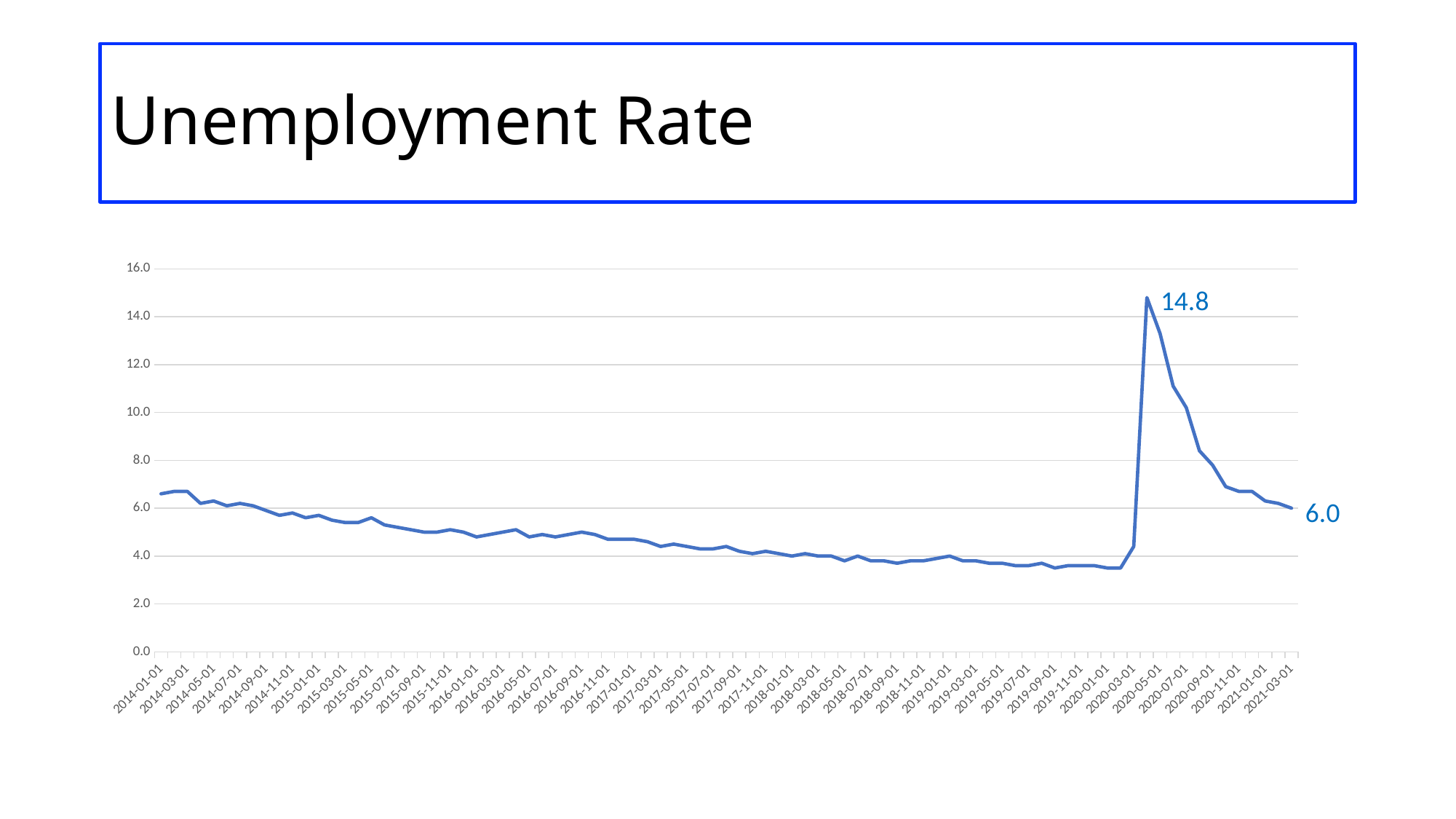
What is the value labelled at the end of the line, at 2021-03-01? 6.0 Is the peak value in 2020 greater or less than 14.0? greater What is the title of the slide? Unemployment Rate What is the difference between the peak value of 14.8 and the final value of 6.0? 8.8 What is the highest value labelled on the line? 14.8 Does the unemployment rate generally rise or fall from 2014-01-01 to 2020-01-01? fall What kind of chart is shown on the slide? line chart Is the value at 2019-09-01 greater or less than 4.0? less Is the value at 2016-01-01 greater or less than 6.0? less What is the highest value shown on the vertical axis? 16.0 Which is larger, the value at 2014-01-01 or the value at 2019-01-01? 2014-01-01